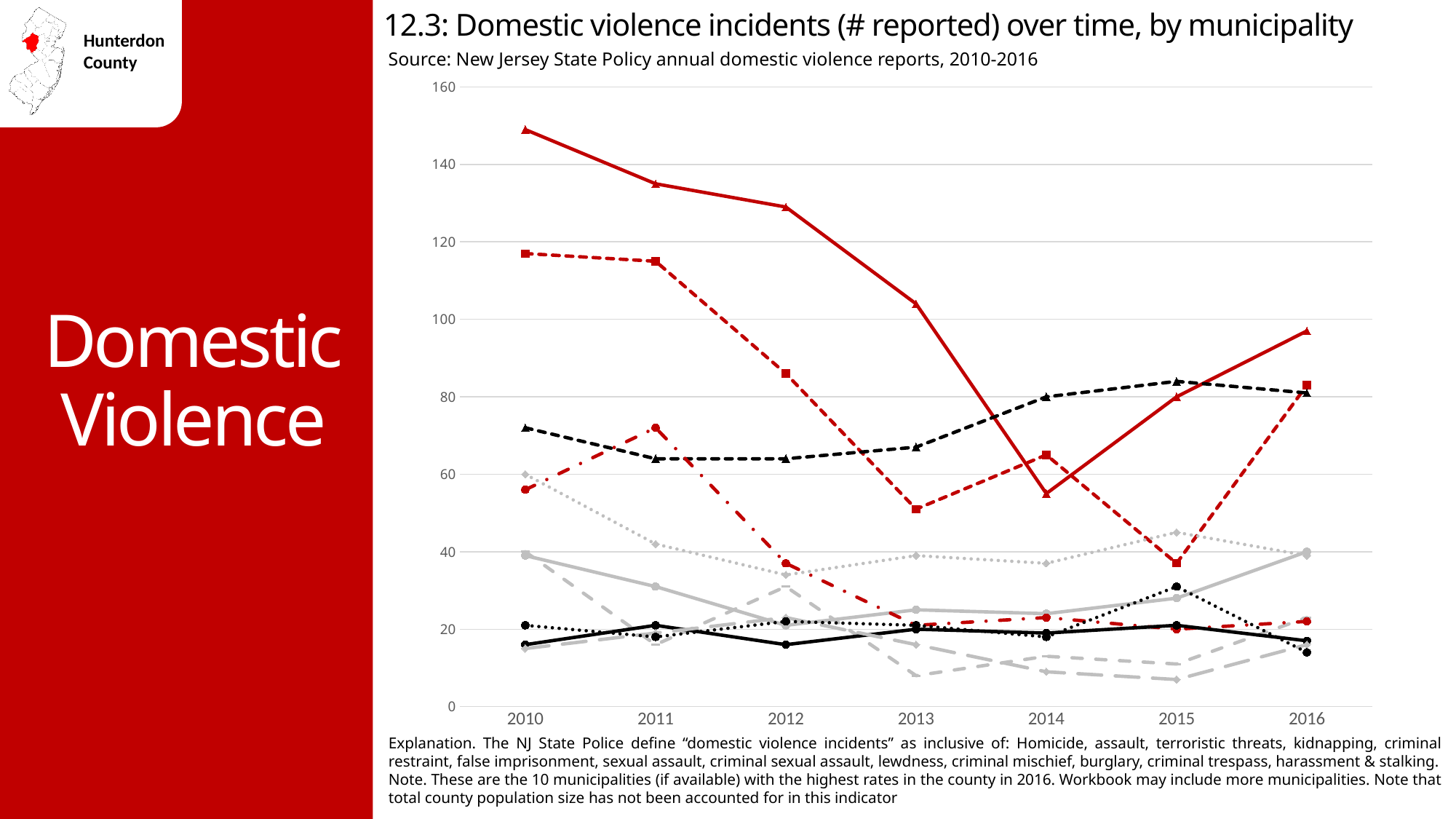
Is the highest value plotted in 2012 greater or less than 120? greater What kind of chart is shown on the slide? line chart Is the lowest value plotted in 2010 greater or less than 20? less What is the last year shown on the x axis? 2016 How many years are shown along the x axis of the chart? 7 Is the lowest value plotted in 2015 greater or less than 20? less What is the first year shown on the x axis? 2010 In which year does the highest plotted value across all lines occur? 2010